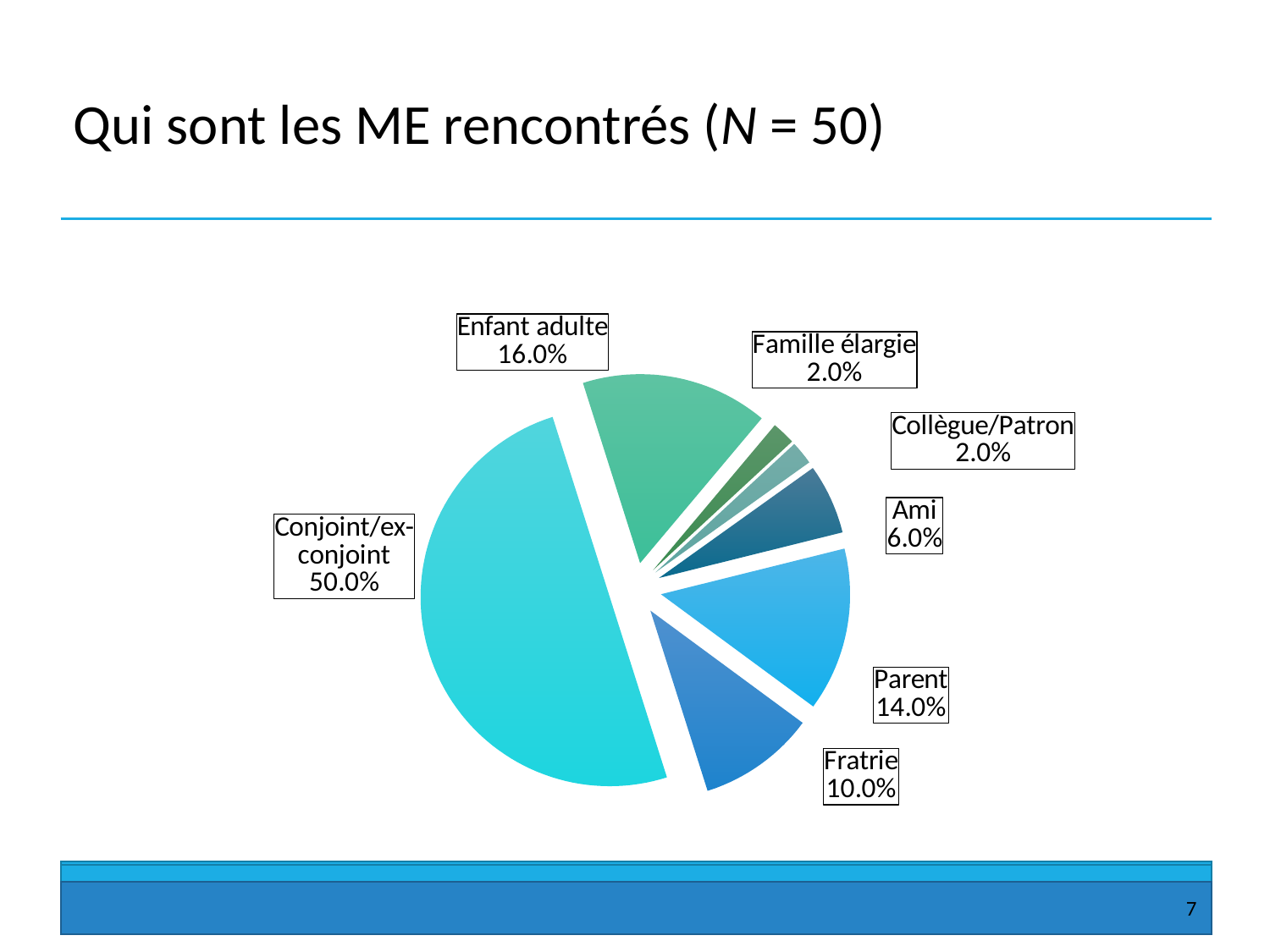
Which is larger, the value for Fratrie or the value for Ami? Fratrie What share of the pie does Conjoint/ex-conjoint represent? 50.0% What is the value for Enfant adulte? 16.0% Which category has the largest slice of the pie? Conjoint/ex-conjoint What is the combined value of Famille élargie and Collègue/Patron? 4.0% What is the value for Fratrie? 10.0% How many categories are shown in the pie chart? 7 What is the value for Ami? 6.0% What is the difference between the values for Enfant adulte and Parent? 2.0% What is the title of the slide containing the chart? Qui sont les ME rencontrés (N = 50) What is the value for Parent? 14.0% What kind of chart is shown on the slide? Pie chart